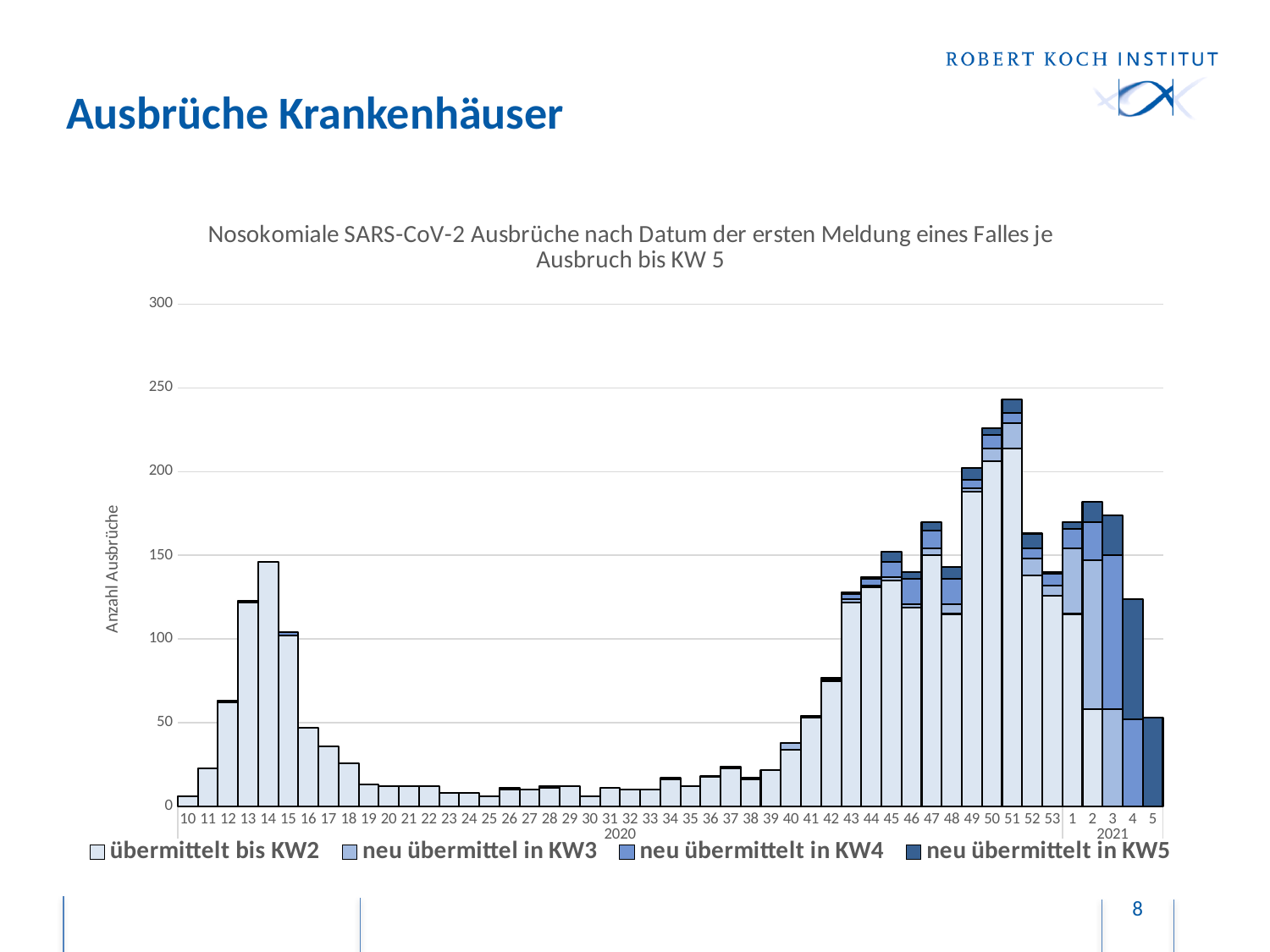
How many calendar weeks (bars) are plotted along the x axis? 49 Is the total for KW 5 of 2021 greater or less than 100? less What kind of chart is shown on the slide? Stacked bar chart Is the total for KW 20 of 2020 greater or less than 50? less Do the totals rise or fall from KW 40 to KW 51 of 2020? rise Which bar is taller, KW 13 or KW 14 of 2020? KW 14 Is the total for KW 14 of 2020 greater or less than 100? greater How many series does the legend list? 4 Which calendar week has the highest total number of outbreaks? KW 51 (2020) What is the first legend entry? übermittelt bis KW2 What is the label of the y axis? Anzahl Ausbrüche